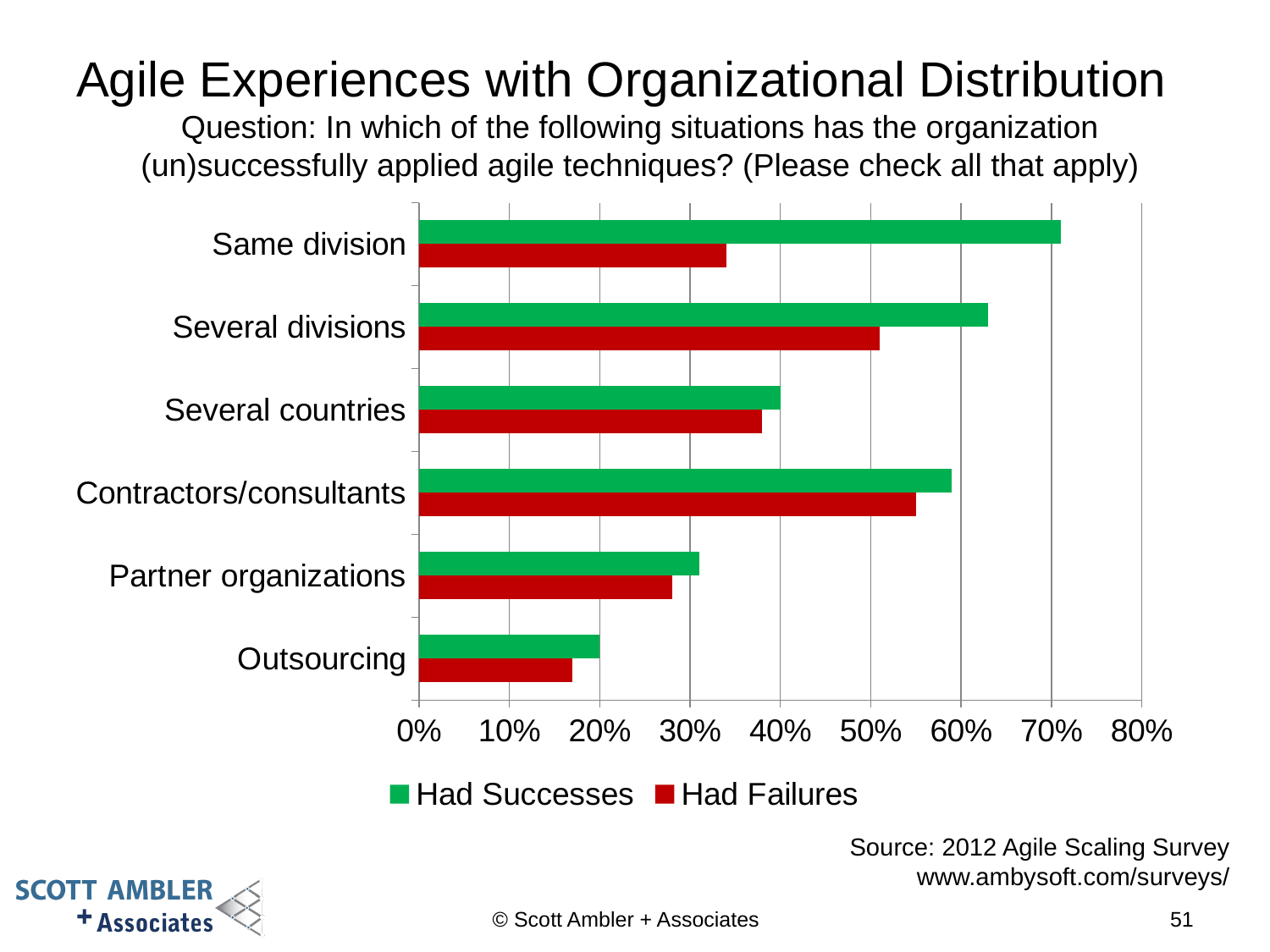
How many categories are shown on the chart? 6 For Same division, which is larger: Had Successes or Had Failures? Had Successes What kind of chart is shown on the slide? bar chart Which category has the lowest value for Had Failures? Outsourcing How many series does the legend list? 2 Is the Had Successes value for Contractors/consultants greater or less than 50%? greater Is the Had Successes value for Same division greater or less than 60%? greater Is the Had Failures value for Same division greater or less than 40%? less Which category has the highest value for Had Successes? Same division What are the two series named in the legend? Had Successes and Had Failures Which category has the lowest value for Had Successes? Outsourcing